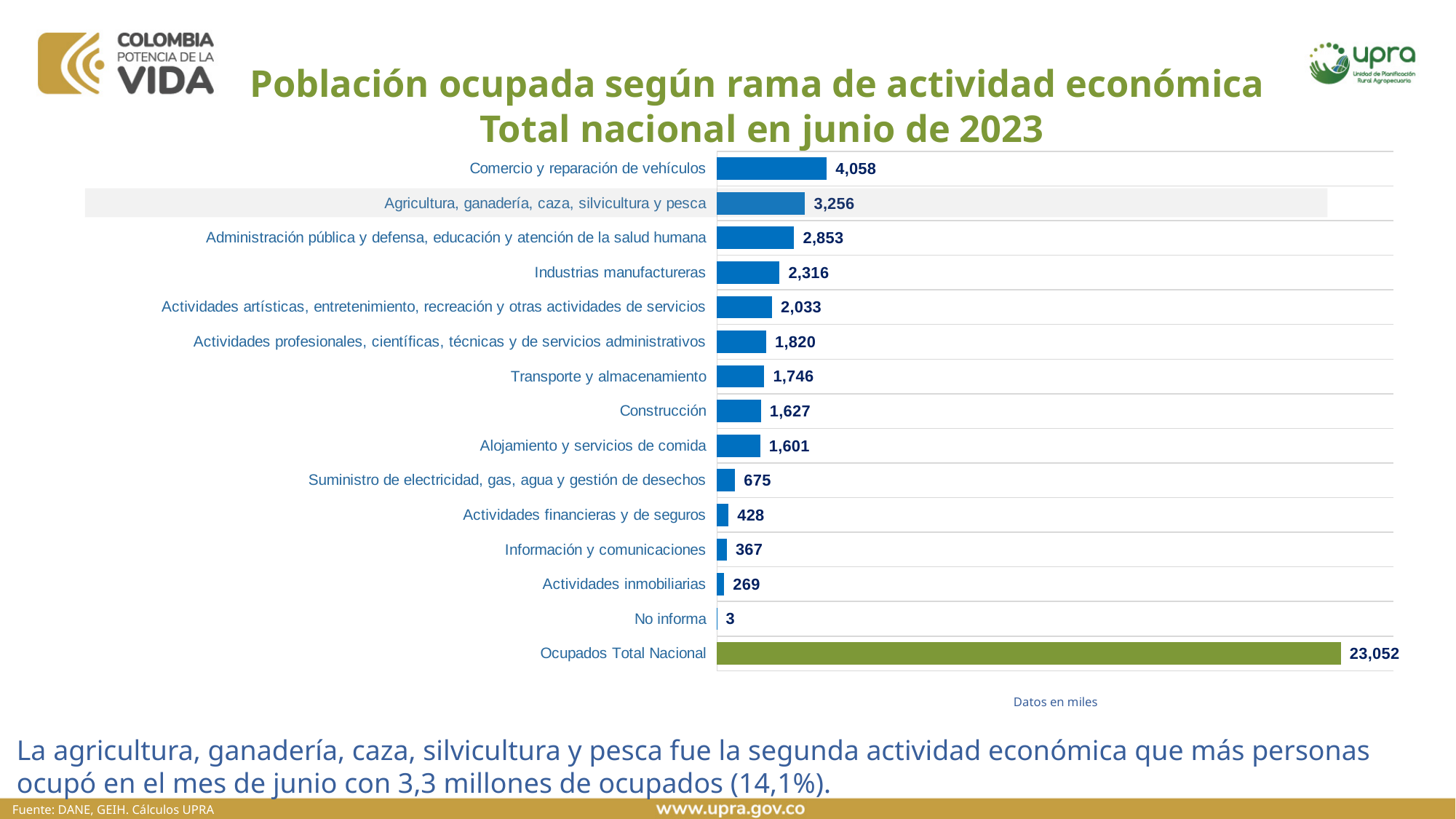
How many bars are shown in the chart, including the Ocupados Total Nacional bar? 15 What is the value for Industrias manufactureras? 2,316 Excluding the Ocupados Total Nacional bar, which economic activity has the highest value? Comercio y reparación de vehículos What is the difference between the values for Comercio y reparación de vehículos and Agricultura, ganadería, caza, silvicultura y pesca? 802 What is the value shown for Ocupados Total Nacional? 23,052 What is the value for Actividades inmobiliarias? 269 What kind of chart is shown on the slide? Bar chart Which is larger, the value for Transporte y almacenamiento or the value for Construcción? Transporte y almacenamiento What is the value for Comercio y reparación de vehículos? 4,058 According to the note below the chart, in what units are the data expressed? Datos en miles What is the value for Agricultura, ganadería, caza, silvicultura y pesca? 3,256 Which category has the lowest value in the chart? No informa